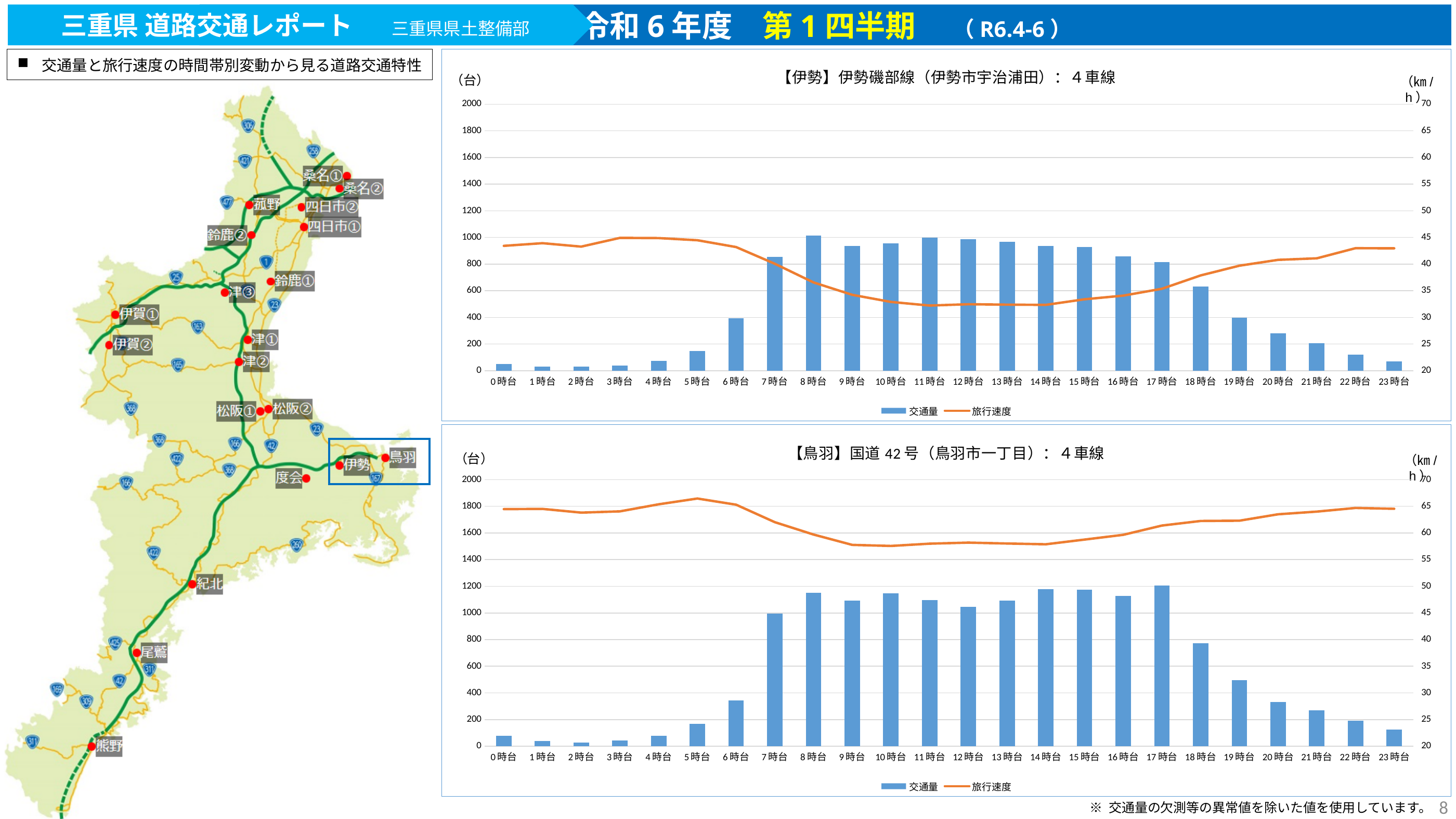
How many time-of-day categories are shown on the x axis of the top chart (【伊勢】伊勢磯部線)? 24 In the top chart (【伊勢】伊勢磯部線), is the 交通量 value for 7時台 greater or less than 800? greater In the bottom chart (【鳥羽】国道42号), is the 旅行速度 value for 10時台 greater or less than 60 km/h? less In the bottom chart (【鳥羽】国道42号), which has the larger 交通量, 17時台 or 18時台? 17時台 In the bottom chart (【鳥羽】国道42号), is the 交通量 value for 8時台 greater or less than 1000? greater In the top chart (【伊勢】伊勢磯部線), which has the larger 交通量, 8時台 or 18時台? 8時台 In the bottom chart (【鳥羽】国道42号), do the 交通量 bars rise or fall from 17時台 to 23時台? fall In the top chart (【伊勢】伊勢磯部線), does the 旅行速度 line rise or fall from 7時台 to 11時台? fall How many series does the legend of the bottom chart (【鳥羽】国道42号) list? 2